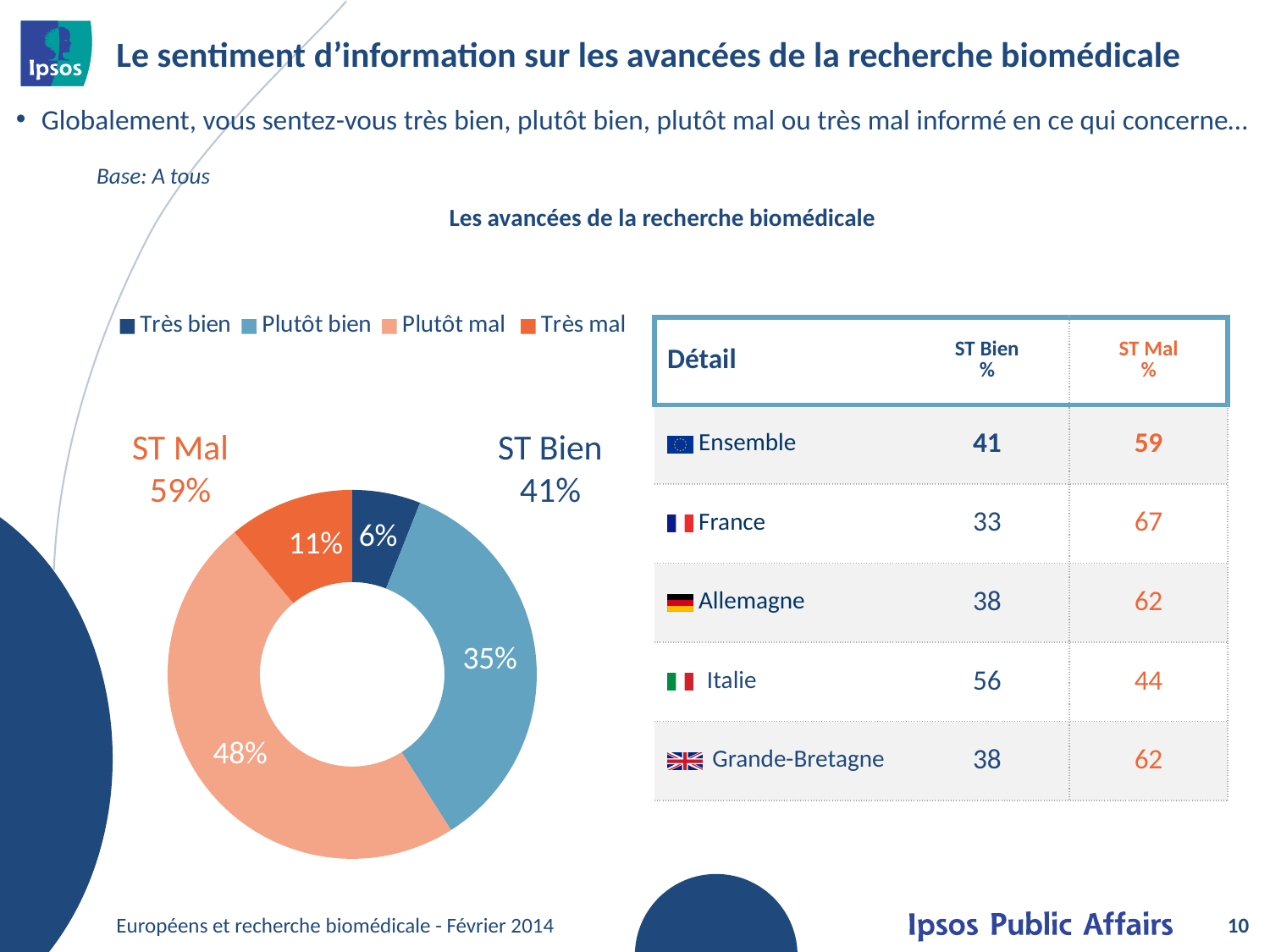
How many entries does the chart legend list? 4 What percentage of respondents answered "Très bien" in the chart? 6% What percentage of respondents answered "Très mal" in the chart? 11% How many slices does the chart have? 4 What type of chart is shown on the slide? Pie chart (donut) What is the difference between the "Plutôt mal" and "Plutôt bien" slices in the chart? 13 percentage points What is the combined share labelled "ST Mal" next to the chart? 59% What percentage of respondents answered "Plutôt bien" in the chart? 35% What percentage of respondents answered "Plutôt mal" in the chart? 48% Which response category has the largest slice in the chart? Plutôt mal Which response category has the smallest slice in the chart? Très bien Which is larger in the chart, the "Très mal" slice or the "Très bien" slice? Très mal